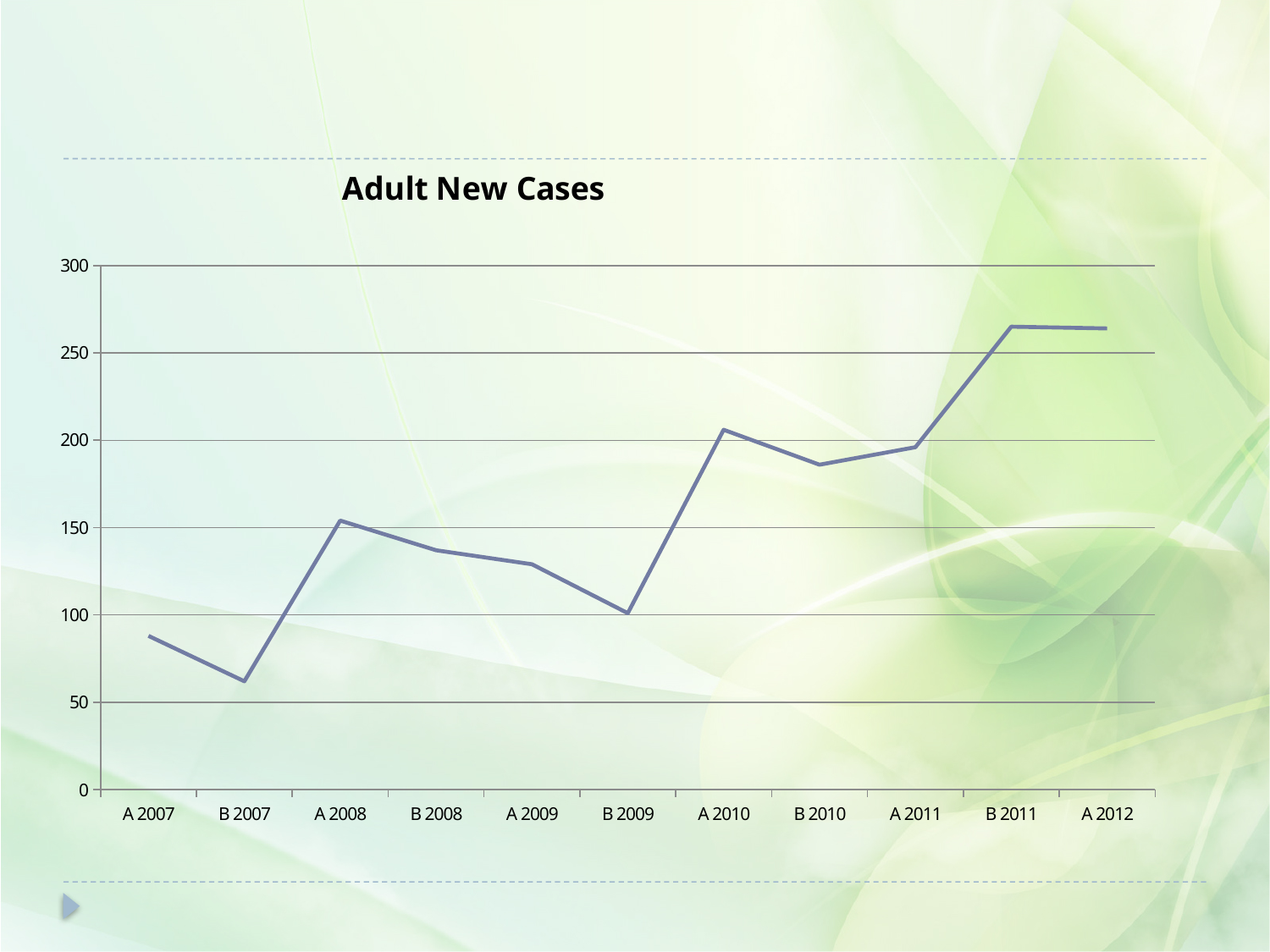
Is the value for B 2010 greater or less than 200? less Which category has the lowest value? B 2007 How many categories are plotted along the x axis? 11 What kind of chart is shown on the slide? line chart Which is larger, the value for A 2010 or the value for B 2010? A 2010 Overall, do the values rise or fall from A 2007 to A 2012? rise Is the value for A 2012 greater or less than 250? greater Is the value for B 2007 greater or less than 50? greater What is the title of the chart? Adult New Cases Which is larger, the value for A 2008 or the value for B 2008? A 2008